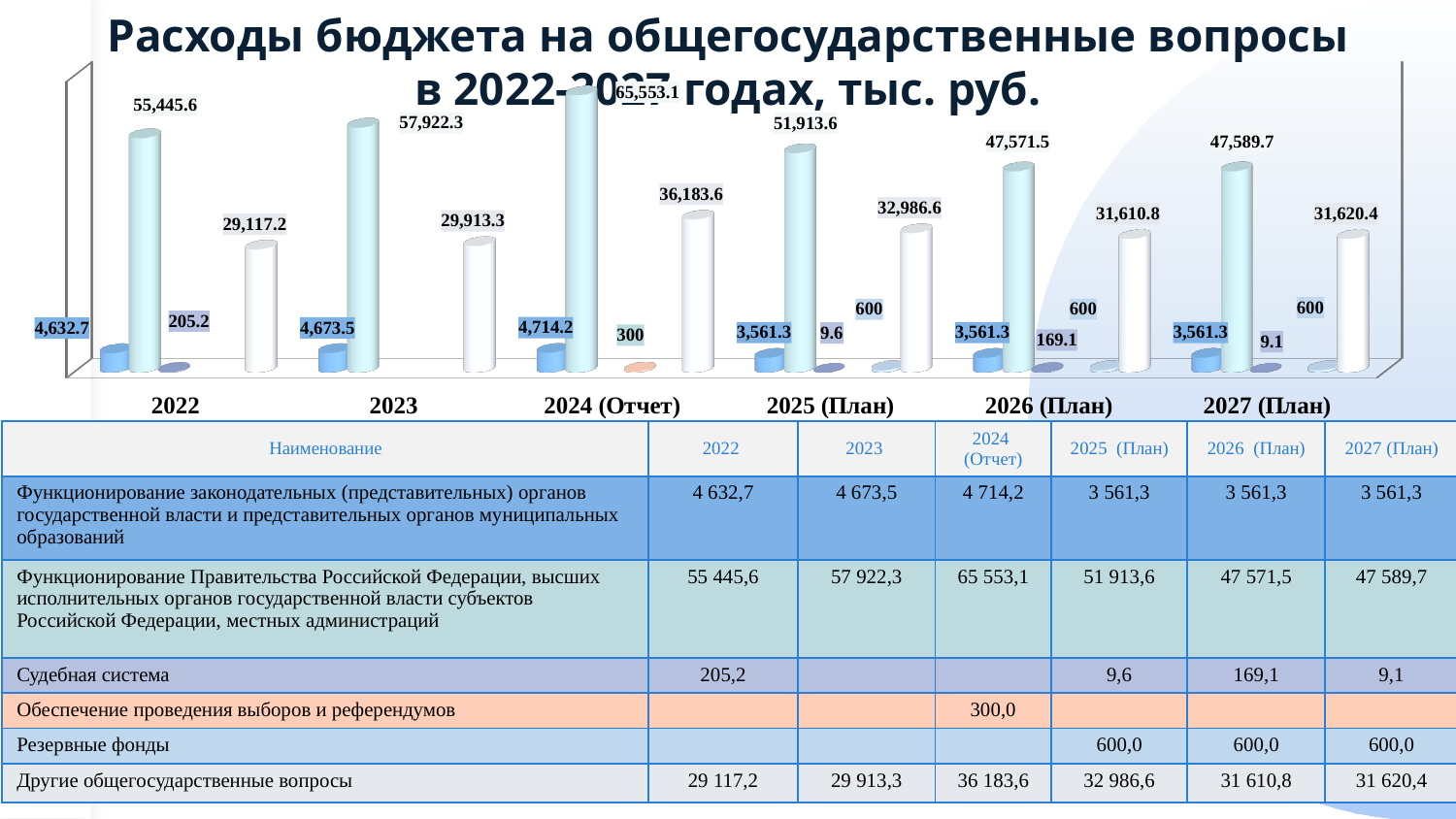
In which year is the value for «Функционирование Правительства Российской Федерации...» the highest? 2024 (Отчет) From 2022 to 2024 (Отчет), do the values for «Функционирование законодательных (представительных) органов...» rise or fall? rise What is the difference between the 2024 (Отчет) and 2023 values for «Функционирование Правительства Российской Федерации...»? 7,630.8 What is the value for «Обеспечение проведения выборов и референдумов» in 2024 (Отчет)? 300 What is the value for «Другие общегосударственные вопросы» in 2024 (Отчет)? 36,183.6 What is the title of the chart? Расходы бюджета на общегосударственные вопросы в 2022-2027 годах, тыс. руб. How many year categories are shown on the x axis of the chart? 6 What is the value for «Судебная система» in 2026 (План)? 169.1 What is the difference between the 2022 and 2026 (План) values for «Судебная система»? 36.1 In which year is the value for «Судебная система» the lowest? 2027 (План) What kind of chart is shown on the slide? bar chart Which is larger for «Другие общегосударственные вопросы»: the value in 2025 (План) or in 2026 (План)? 2025 (План)